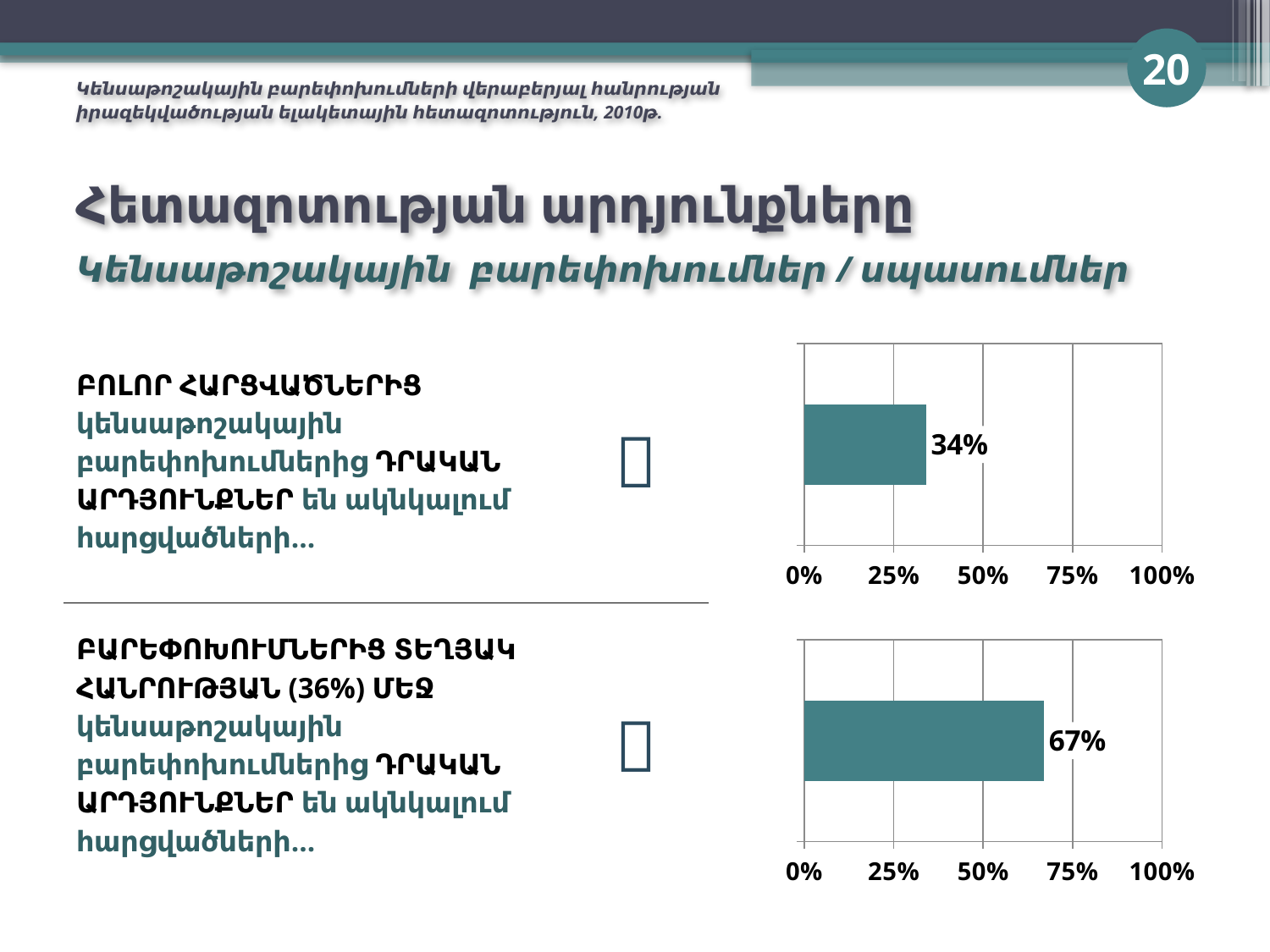
Which chart shows the larger bar value, the top chart or the bottom chart? the bottom chart What is the interval between consecutive tick labels on the x axis of the bottom chart? 25% How many bars are plotted in the top chart? 1 What is the difference between the bar value in the bottom chart (67%) and the bar value in the top chart (34%)? 33 percentage points In the bottom chart, what value is shown by the data label on the bar? 67% What kind of chart is the top chart? bar chart In the top chart, what value is shown by the data label on the bar? 34% What kind of chart is the bottom chart? bar chart How many bars are plotted in the bottom chart? 1 Is the value of the bar in the bottom chart greater or less than 50%? greater What is the highest tick value shown on the x axis of the top chart? 100% Is the value of the bar in the top chart greater or less than 50%? less